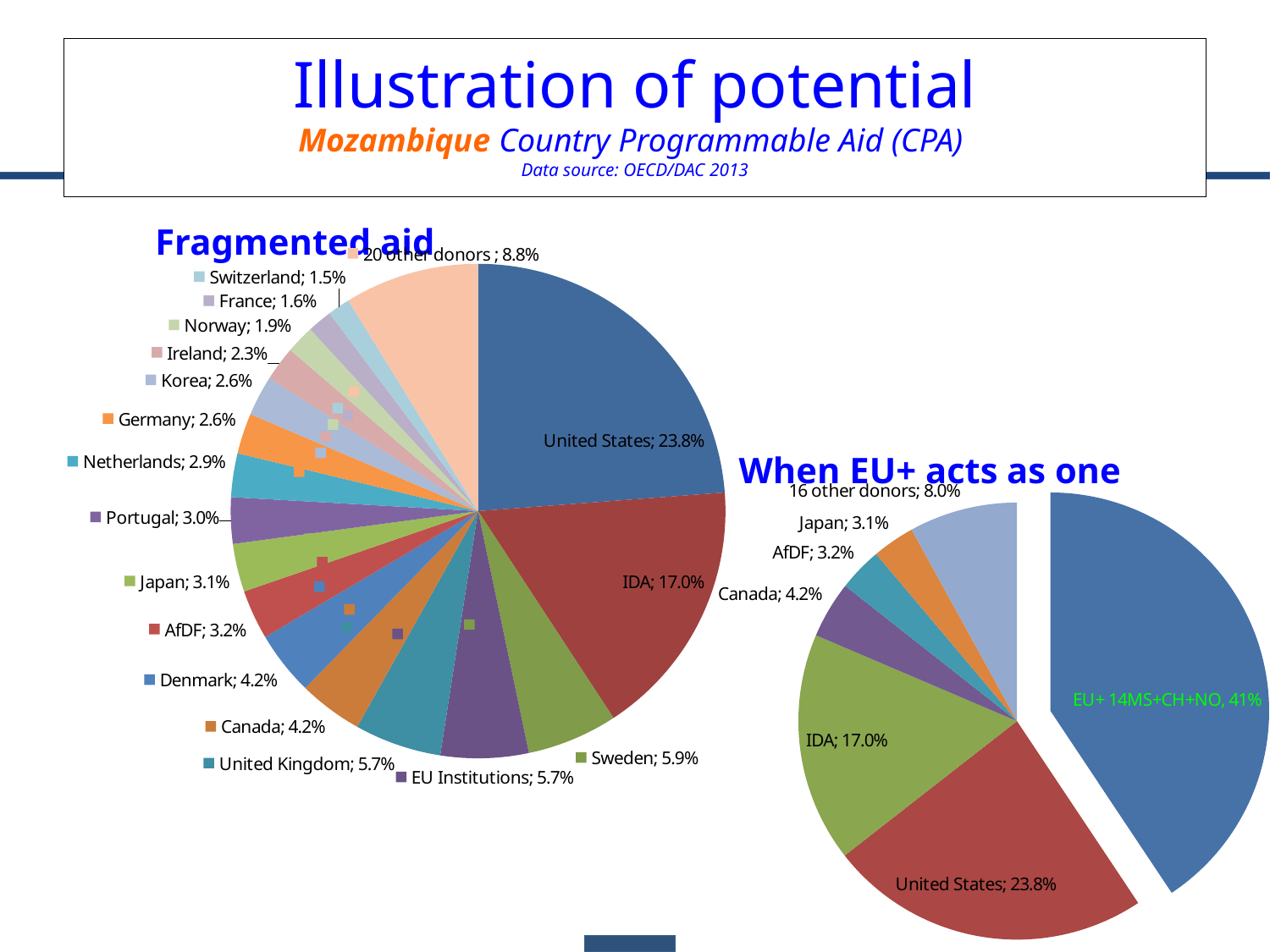
How many slices does the 'When EU+ acts as one' pie chart have? 7 In the 'Fragmented aid' chart, which donor has the largest share? United States In the 'Fragmented aid' chart, what share does the United States have? 23.8% What type of chart is used for 'When EU+ acts as one'? Pie chart How many slices does the 'Fragmented aid' pie chart have? 18 In the 'When EU+ acts as one' chart, which slice is the largest? EU+ 14MS+CH+NO In the 'Fragmented aid' chart, what is the difference between the United States share and the IDA share? 6.8% In the 'When EU+ acts as one' chart, what share do the 16 other donors have? 8.0% In the 'When EU+ acts as one' chart, what share does EU+ 14MS+CH+NO have? 41% In the 'Fragmented aid' chart, which named donor has the smallest share? Switzerland In the 'Fragmented aid' chart, what share does Sweden have? 5.9% In the 'Fragmented aid' chart, which is larger, the share for Portugal or the share for Netherlands? Portugal